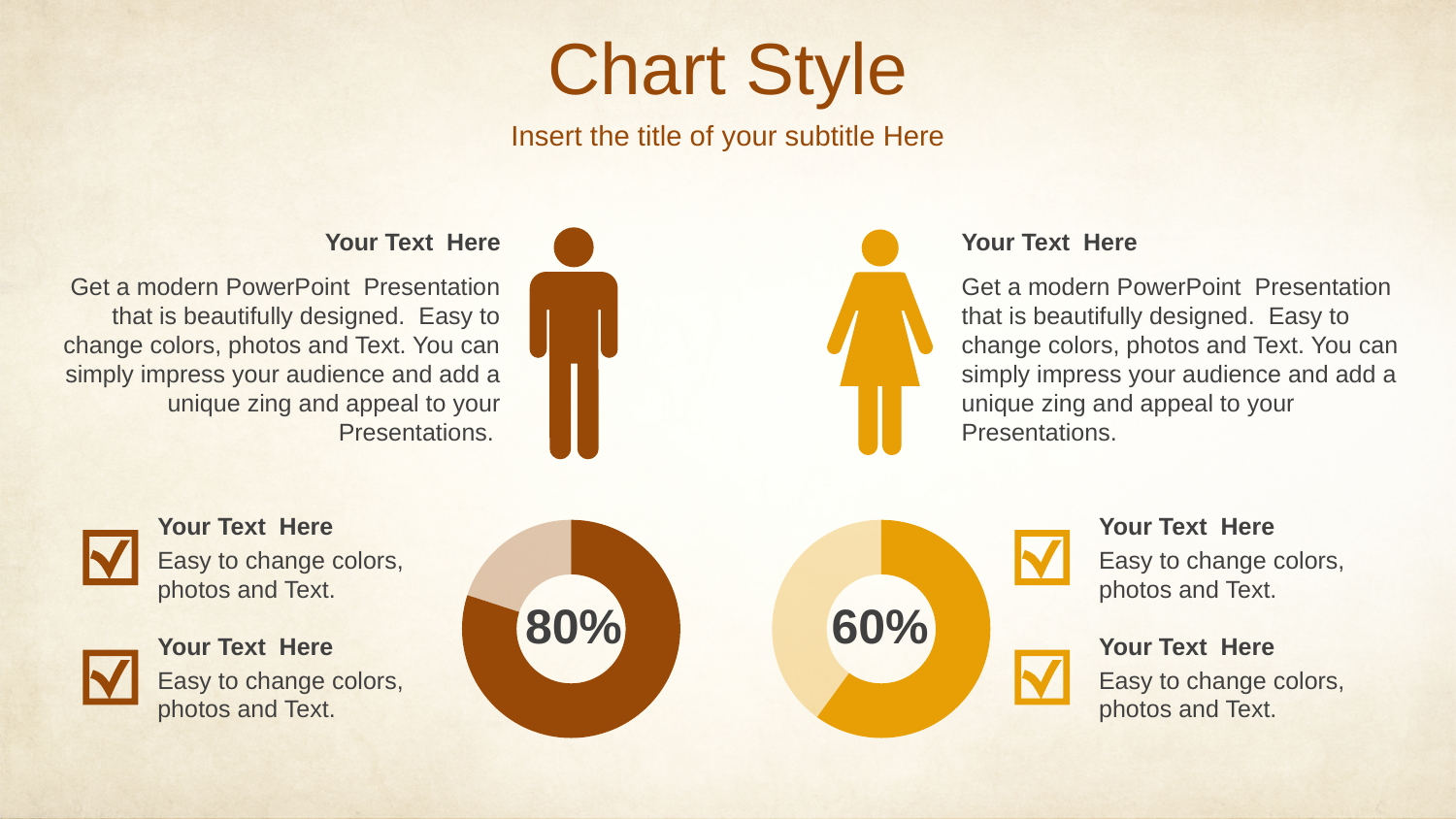
What colour is the filled portion of the right donut chart? gold Is the value shown in the left donut chart greater or less than 50%? greater Is the value shown in the right donut chart greater or less than 75%? less What percentage is shown in the centre of the left donut chart? 80% What colour is the filled portion of the left donut chart? brown What percentage is shown in the centre of the right donut chart? 60% What is the difference between the percentage in the left donut chart and the percentage in the right donut chart? 20% Which donut chart shows the higher percentage, the left one or the right one? the left one Which donut chart shows the lower percentage, the left one or the right one? the right one Which donut chart, left or right, sits below the female figure icon? the right one How many donut charts are on the slide? 2 What kind of chart is used to display the 80% value? donut chart